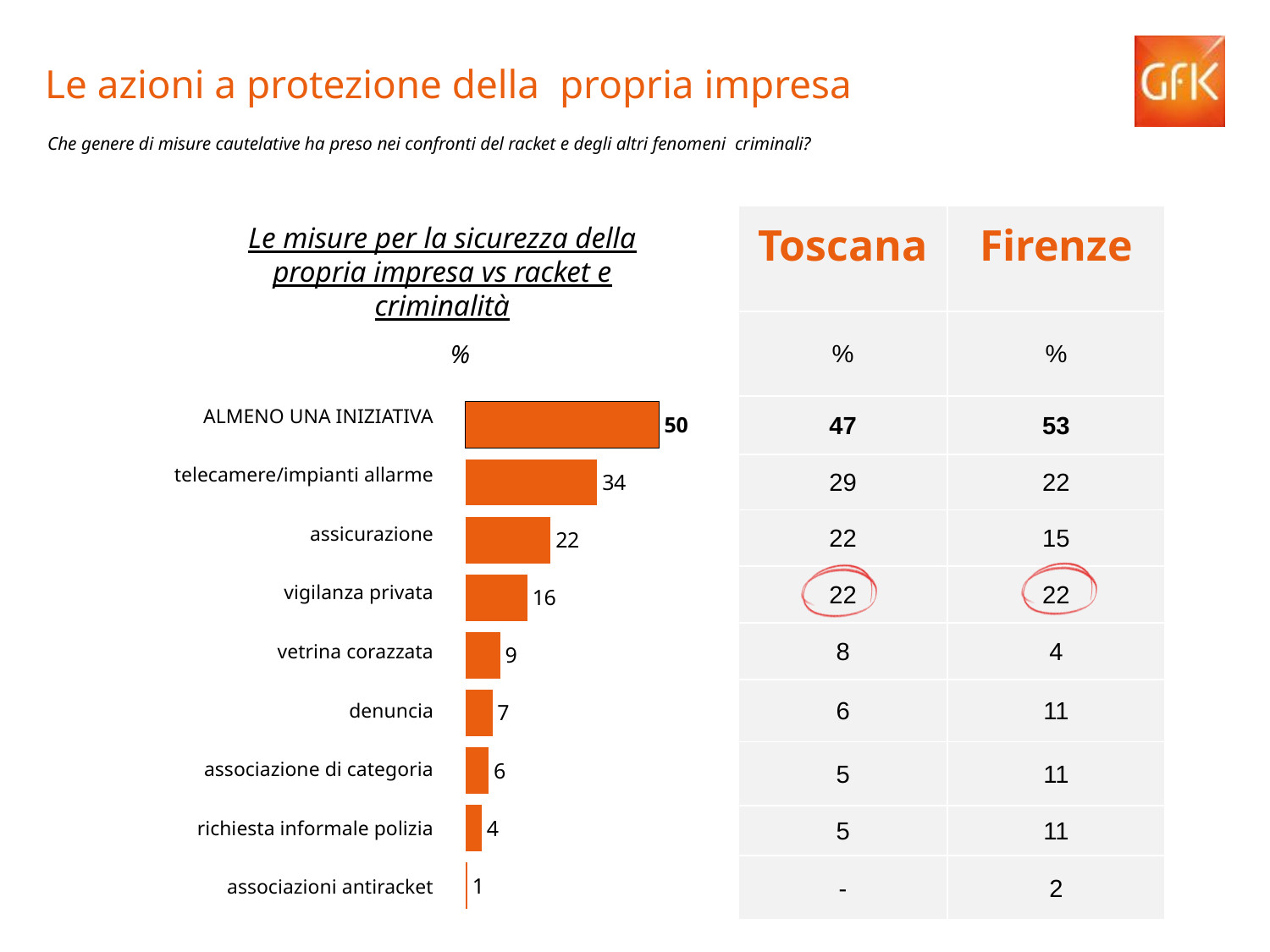
What is the value for associazioni antiracket in the bar chart? 1 Which is larger in the bar chart: vetrina corazzata or denuncia? vetrina corazzata What is the value for vigilanza privata in the bar chart? 16 Which category has the lowest value in the bar chart? associazioni antiracket What is the difference between the values for telecamere/impianti allarme and assicurazione in the bar chart? 12 What is the value for associazione di categoria in the bar chart? 6 Which category has the highest value in the bar chart? ALMENO UNA INIZIATIVA Do the values in the bar chart rise or fall from the top category to the bottom category? fall What is the value for telecamere/impianti allarme in the bar chart? 34 What kind of chart is shown on the slide? bar chart What is the title of the bar chart? Le misure per la sicurezza della propria impresa vs racket e criminalità How many categories are shown in the bar chart? 9